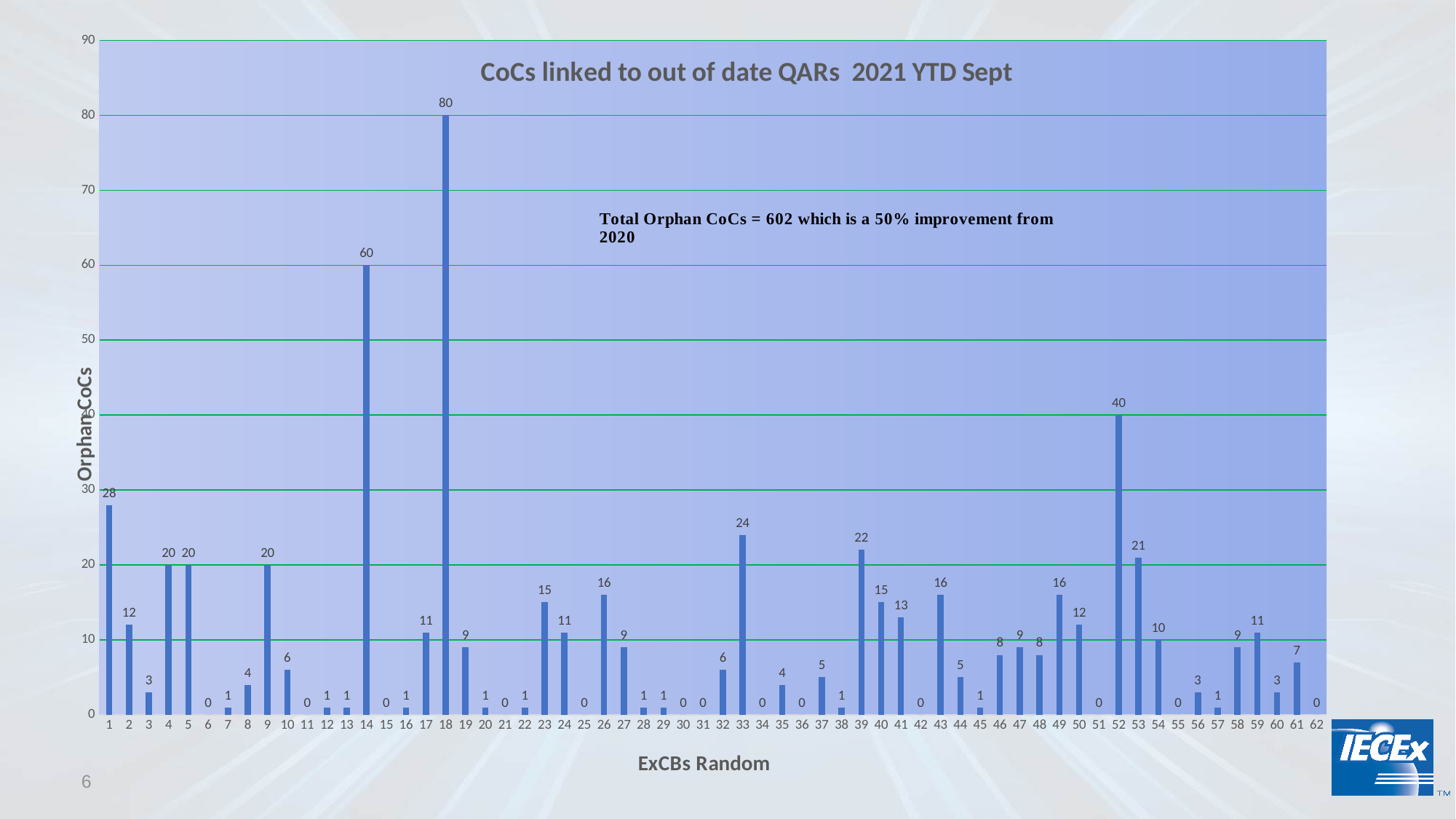
What is the difference between the values for ExCB 52 and ExCB 53? 19 What is the value for ExCB 33? 24 What is the value for ExCB 18? 80 What is the label of the y axis? Orphan CoCs What is the value for ExCB 52? 40 How many ExCB categories are shown on the x axis? 62 What is the difference between the values for ExCB 18 and ExCB 14? 20 Which is larger, the value for ExCB 39 or the value for ExCB 43? ExCB 39 Which ExCB has the highest number of Orphan CoCs? 18 What is the title of the chart? CoCs linked to out of date QARs 2021 YTD Sept What kind of chart is shown on the slide? Bar chart What is the value for ExCB 1? 28